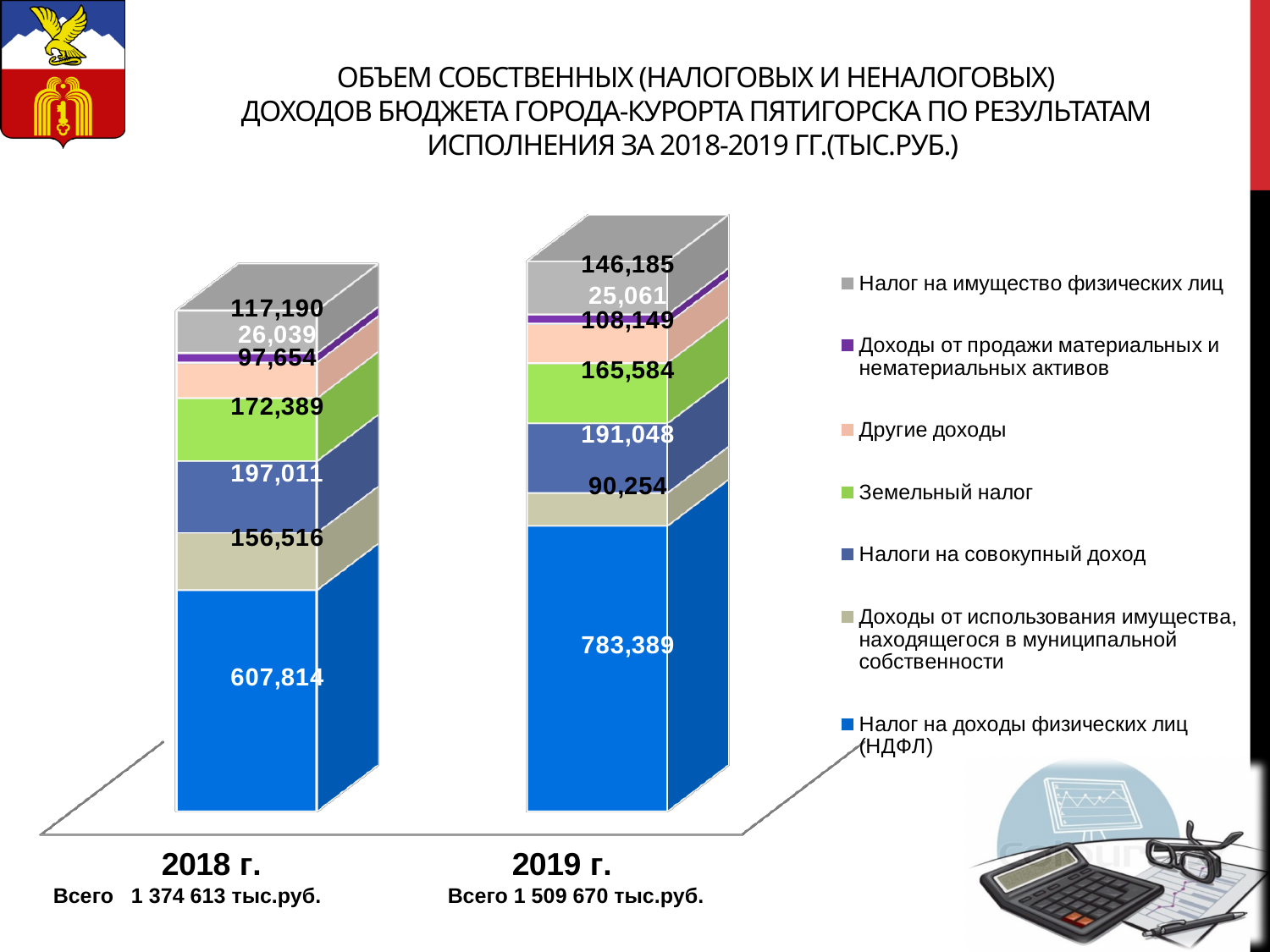
What is the value of Доходы от продажи материальных и нематериальных активов for 2019 г.? 25,061 How many categories (years) are plotted on the x axis? 2 Which series has the smallest value in the 2019 г. bar? Доходы от продажи материальных и нематериальных активов By how much did Налог на доходы физических лиц (НДФЛ) increase from 2018 г. to 2019 г.? 175,575 Which series has the largest value in the 2018 г. bar? Налог на доходы физических лиц (НДФЛ) What is the total of the 2019 г. stacked bar as printed on the slide? 1 509 670 тыс.руб. What is the value of Налог на имущество физических лиц for 2018 г.? 117,190 What is the value of Налог на доходы физических лиц (НДФЛ) for 2019 г.? 783,389 Which year has the larger value for Доходы от использования имущества, находящегося в муниципальной собственности? 2018 г. What is the value of Земельный налог for 2018 г.? 172,389 How many series does the legend list? 7 What kind of chart is shown on the slide? stacked bar chart